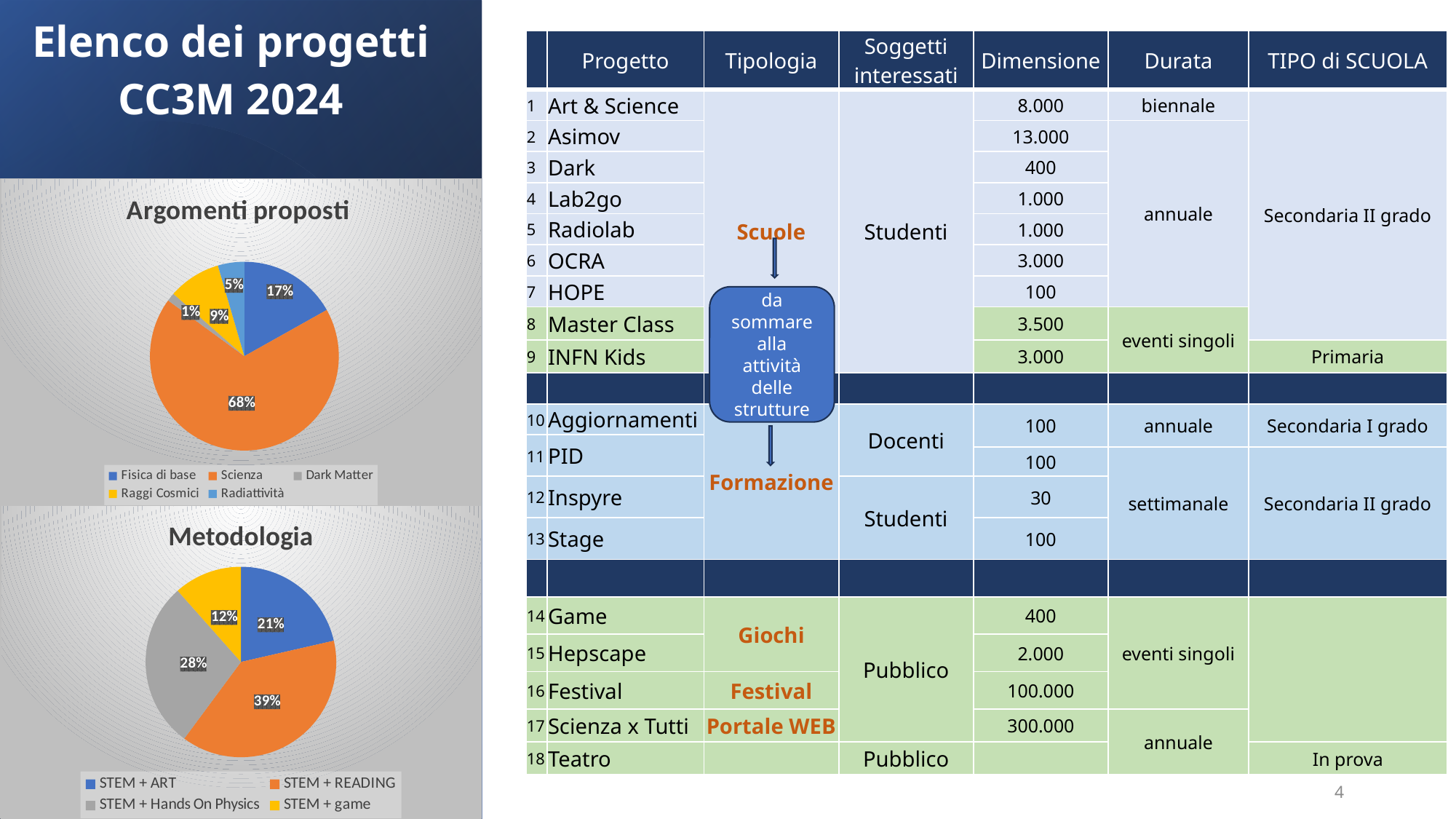
In the "Argomenti proposti" chart, what is the value for Fisica di base? 17% In the "Metodologia" chart, what is the share for STEM + READING? 39% In the "Metodologia" chart, what is the difference between STEM + READING and STEM + ART? 18% How many categories does the "Argomenti proposti" chart show? 5 What kind of chart is "Metodologia"? Pie chart In the "Metodologia" chart, which is larger, STEM + ART or STEM + Hands On Physics? STEM + Hands On Physics In the "Argomenti proposti" chart, which category has the smallest share? Dark Matter In the "Metodologia" chart, what is the value for STEM + Hands On Physics? 28% In the "Metodologia" chart, which category has the smallest share? STEM + game In the "Argomenti proposti" chart, what is the difference between Raggi Cosmici and Radiattività? 4% In the "Argomenti proposti" chart, what share does Scienza have? 68% In the "Argomenti proposti" chart, which category has the largest share? Scienza